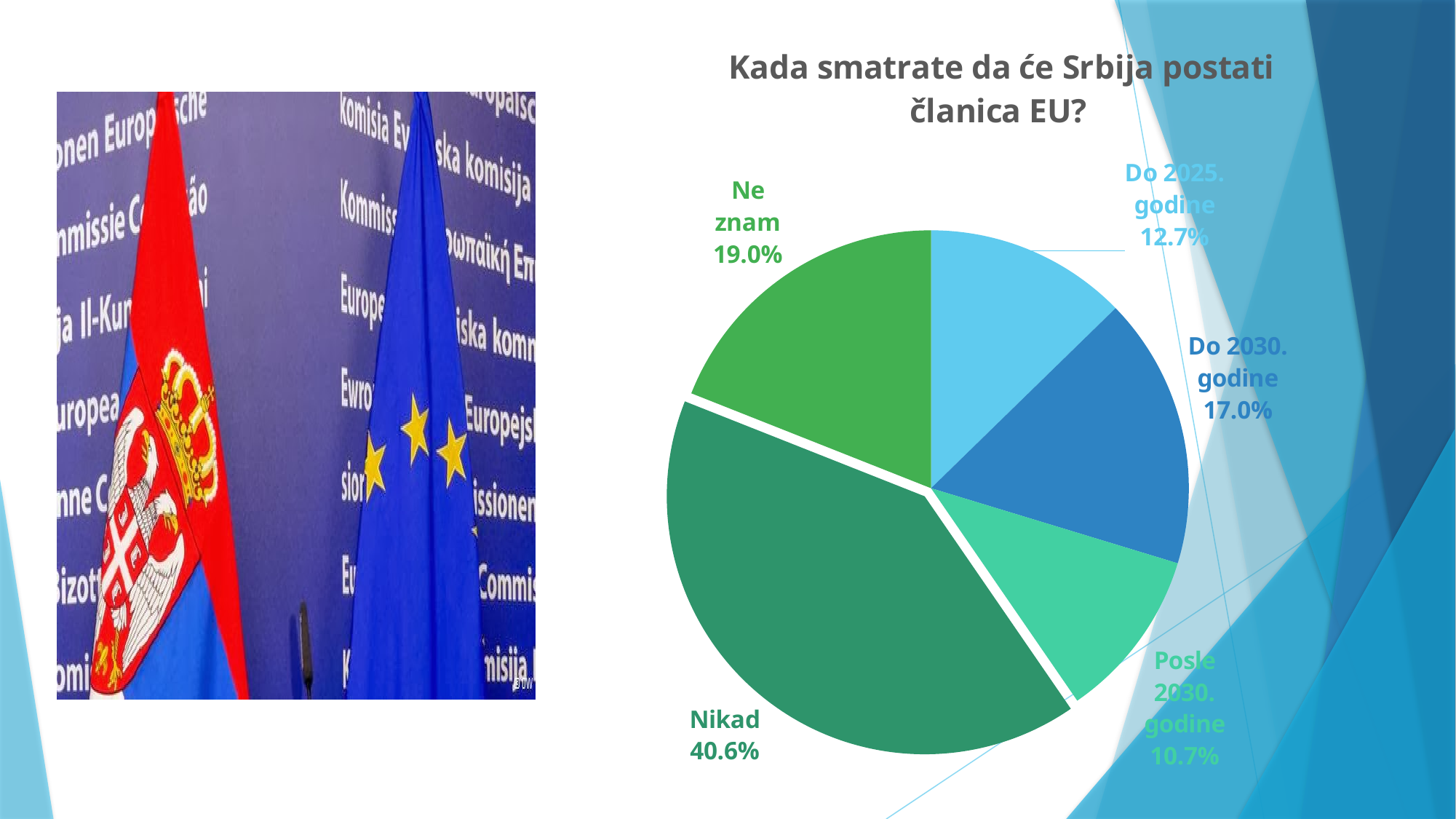
Which category has the smallest slice of the pie? Posle 2030. godine What kind of chart is shown on the slide? pie chart What share of the pie is labelled "Nikad"? 40.6% What share of the pie is labelled "Posle 2030. godine"? 10.7% What is the title of the chart? Kada smatrate da će Srbija postati članica EU? What share of the pie is labelled "Do 2030. godine"? 17.0% Which category has the largest slice of the pie? Nikad Which is larger, the share for "Do 2030. godine" or the share for "Do 2025. godine"? Do 2030. godine What is the difference in percentage points between "Nikad" and "Ne znam"? 21.6 How many slices does the pie chart have? 5 What share of the pie is labelled "Ne znam"? 19.0% What share of the pie is labelled "Do 2025. godine"? 12.7%